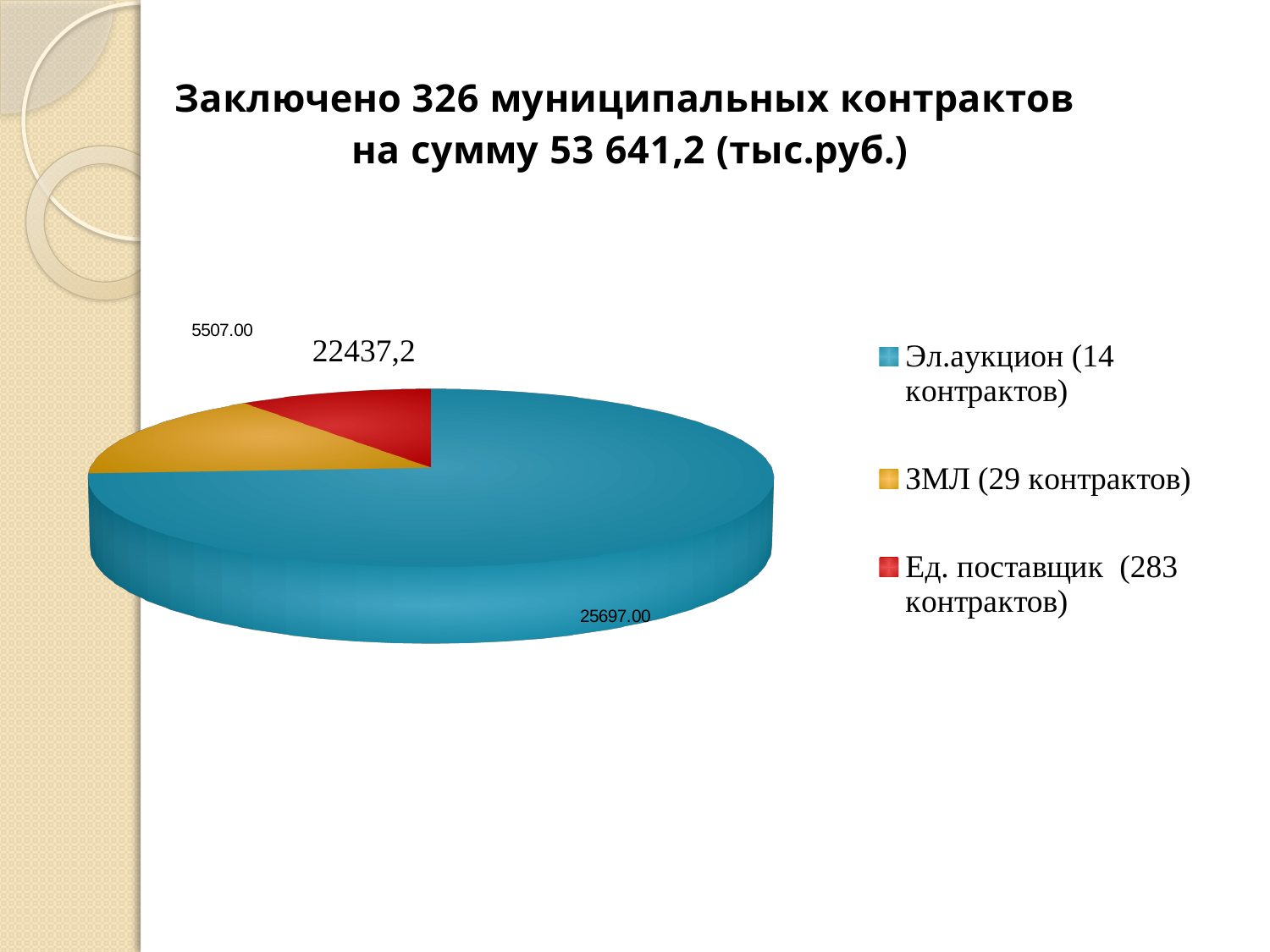
What value is labelled on the blue slice (Эл.аукцион)? 25697.00 How many entries does the legend list? 3 According to the slide title, how many municipal contracts were concluded? 326 Which slice is larger: Эл.аукцион or Ед. поставщик? Эл.аукцион How many slices does the pie chart have? 3 Which slice is larger: Эл.аукцион or ЗМЛ? Эл.аукцион Which category has the largest slice of the pie? Эл.аукцион (14 контрактов) What colour is the slice for Ед. поставщик in the legend? red What kind of chart is shown on the slide? pie chart